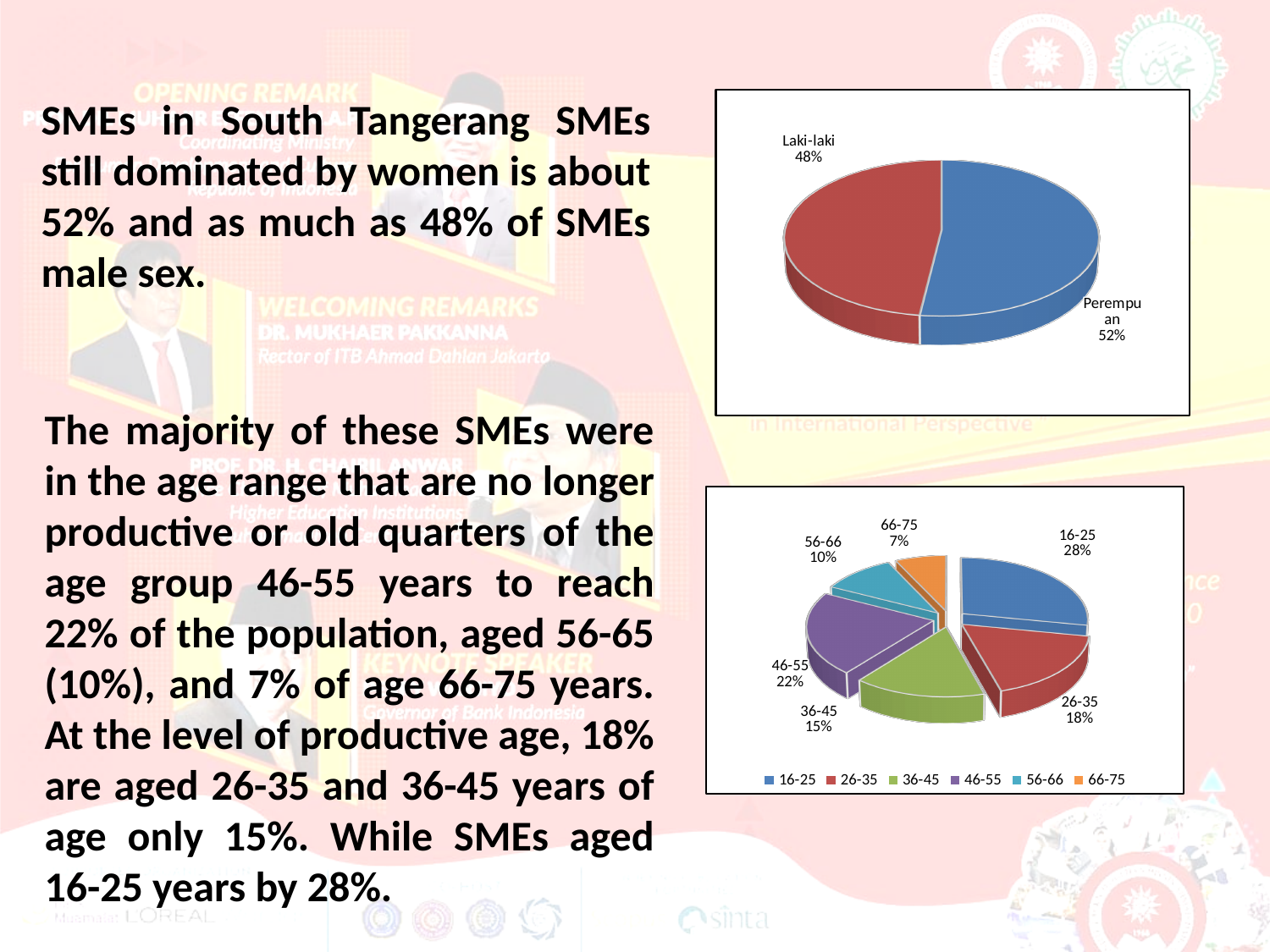
In the bottom pie chart, what share is labelled for the 46-55 age group? 22% In the top pie chart, what share is labelled for Perempuan? 52% In the bottom pie chart, which is larger, the share for 56-66 or the share for 66-75? 56-66 What kind of chart is the top chart on the slide? Pie chart In the top pie chart, what share is labelled for Laki-laki? 48% How many entries does the legend of the bottom pie chart list? 6 In the bottom pie chart, which age group has the largest share? 16-25 In the top pie chart, which slice is larger, Laki-laki or Perempuan? Perempuan In the bottom pie chart, what share is labelled for the 36-45 age group? 15% In the bottom pie chart, which age group has the smallest share? 66-75 In the bottom pie chart, what is the difference between the shares for 16-25 and 26-35? 10% How many age groups are shown in the bottom pie chart? 6